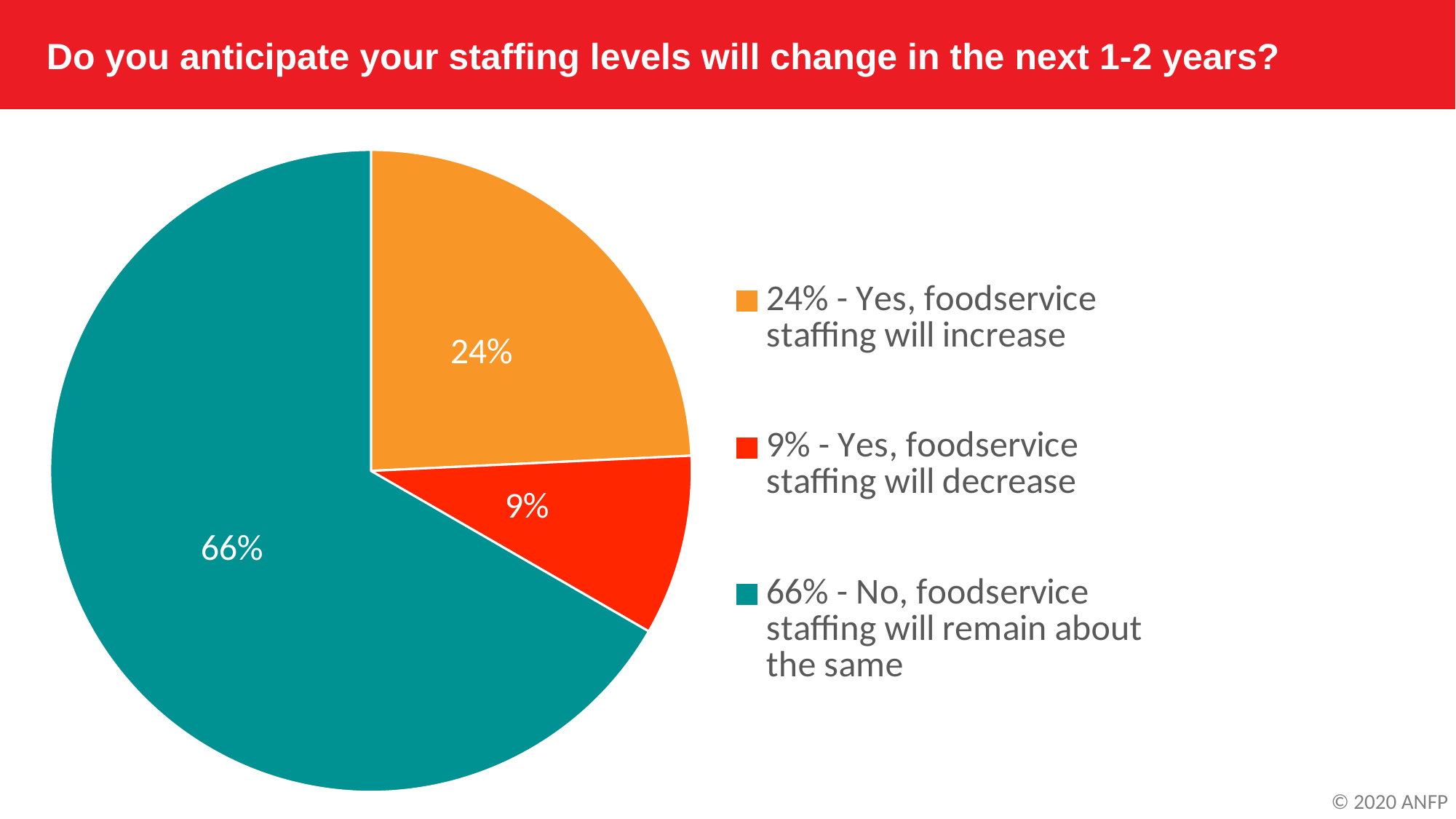
What is the difference in percentage points between the 'will increase' slice and the 'will decrease' slice? 15 What share of respondents said foodservice staffing will remain about the same? 66% What colour is the slice for 'No, foodservice staffing will remain about the same'? teal What is the difference in percentage points between the 'remain about the same' slice and the 'will increase' slice? 42 Which response has the largest slice of the pie? No, foodservice staffing will remain about the same What share of respondents said foodservice staffing will increase? 24% How many entries does the legend list? 3 What kind of chart is shown on the slide? pie chart Which is larger: the share for 'staffing will increase' or the share for 'staffing will decrease'? staffing will increase What share of respondents said foodservice staffing will decrease? 9% Which response has the smallest slice of the pie? Yes, foodservice staffing will decrease How many slices does the pie chart have? 3